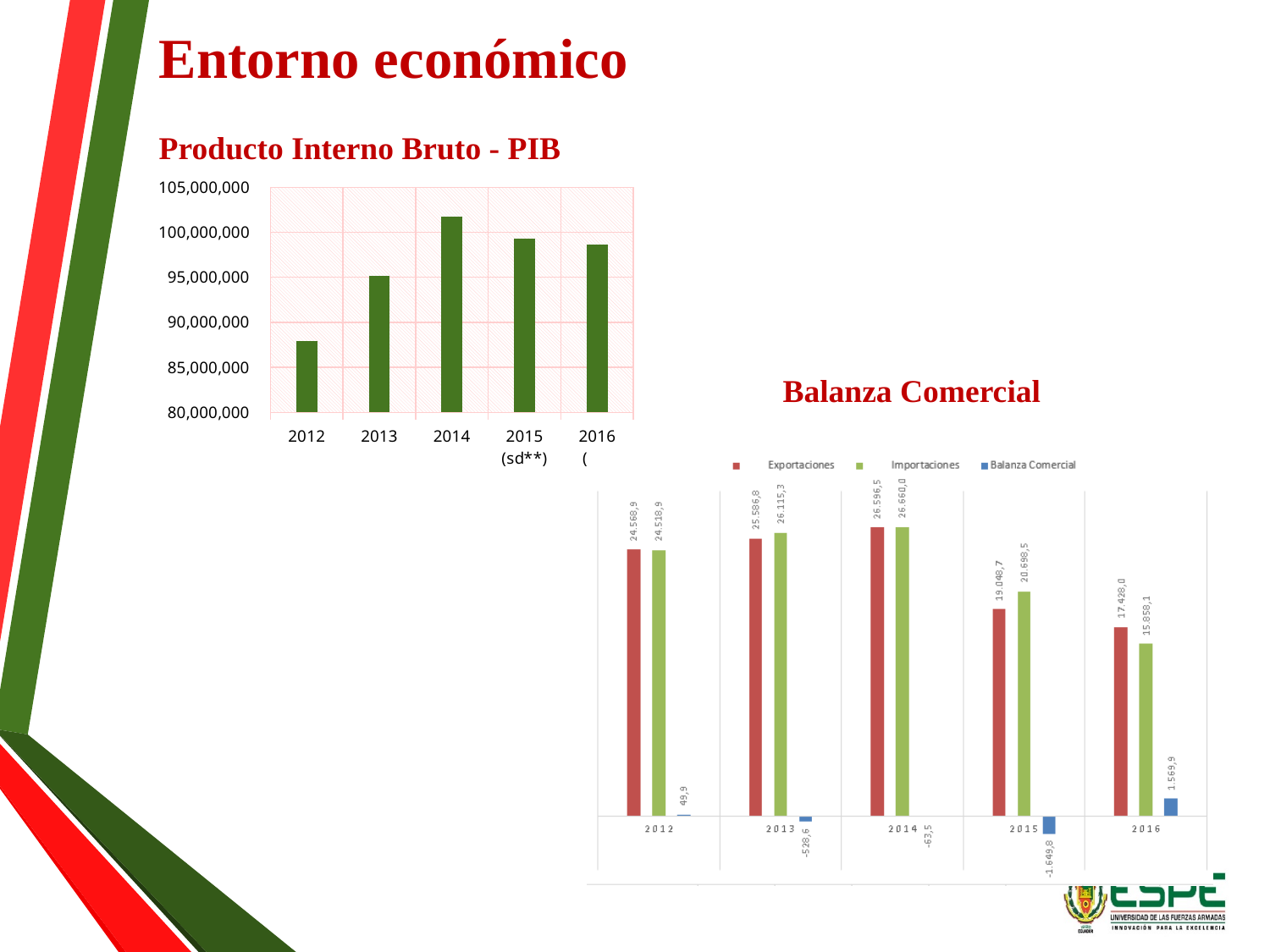
In the Balanza Comercial chart, which year has the lowest Balanza Comercial value? 2015 In the Balanza Comercial chart, which is larger in 2016, Exportaciones or Importaciones? Exportaciones In the Producto Interno Bruto - PIB chart, is the value for 2012 greater or less than 90,000,000? less In the Balanza Comercial chart, what is the value of Importaciones for 2015? 20.698,5 In the Balanza Comercial chart, how many series does the legend list? 3 In the Producto Interno Bruto - PIB chart, how many years are shown on the x axis? 5 In the Balanza Comercial chart, what is the Balanza Comercial value for 2016? 1.569,9 What kind of chart is the Producto Interno Bruto - PIB chart? bar chart In the Producto Interno Bruto - PIB chart, which year has the lowest value? 2012 In the Producto Interno Bruto - PIB chart, which year has the highest value? 2014 In the Producto Interno Bruto - PIB chart, is the value for 2014 greater or less than 100,000,000? greater In the Balanza Comercial chart, what is the value of Exportaciones for 2014? 26.596,5